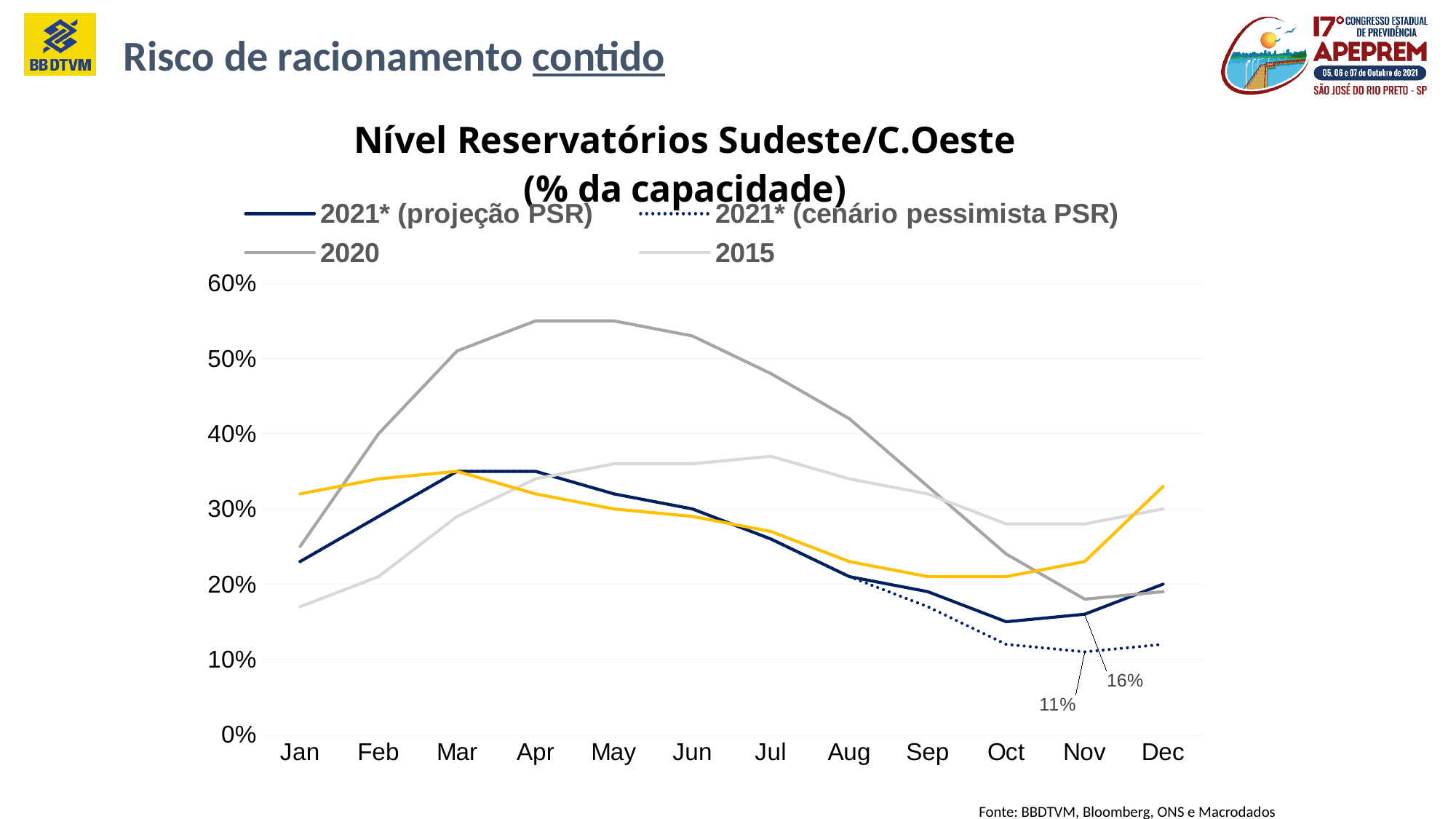
What is the title of the chart? Nível Reservatórios Sudeste/C.Oeste (% da capacidade) What is the value for 2021* (cenário pessimista PSR) in Nov? 11% Does the 2020 series rise or fall from Jul to Nov? fall Is the value for 2020 in Apr greater or less than 50%? greater Is the value for 2015 in Jan greater or less than 20%? less What kind of chart is shown on the slide? line chart What is the difference between the Nov values of 2021* (projeção PSR) and 2021* (cenário pessimista PSR)? 5 percentage points How many months are shown along the x axis? 12 In Nov, which is larger: 2021* (projeção PSR) or 2021* (cenário pessimista PSR)? 2021* (projeção PSR) How many series does the chart legend list? 4 What is the value for 2021* (projeção PSR) in Nov? 16% Which series reaches the highest value on the chart? 2020